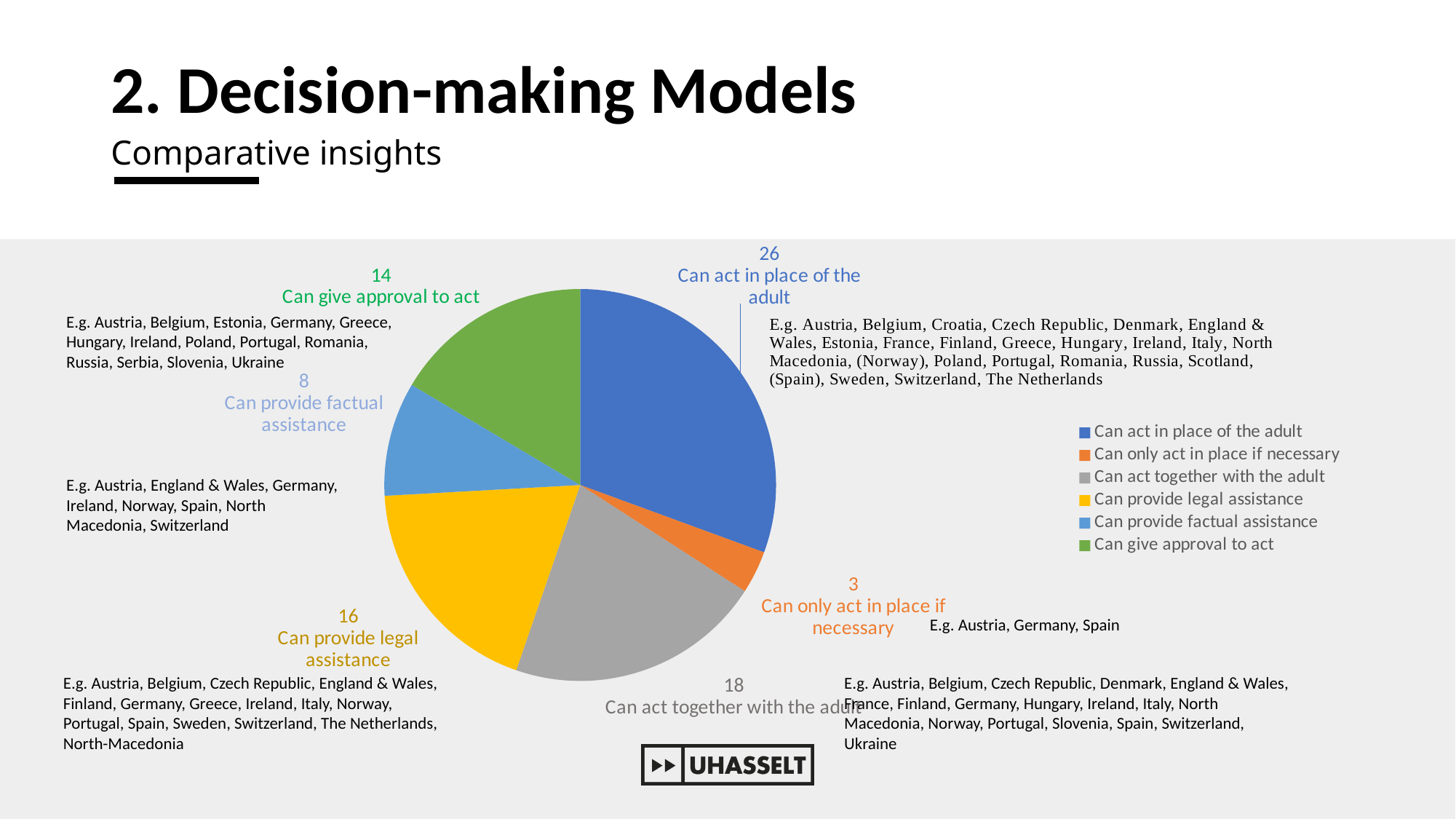
What is the value for 'Can only act in place if necessary'? 3 Which category has the largest slice of the pie? Can act in place of the adult What type of chart is shown on the slide? pie chart How many entries does the legend of the pie chart list? 6 What is the value for 'Can act in place of the adult'? 26 Which category has the smallest slice of the pie? Can only act in place if necessary What is the value for 'Can act together with the adult'? 18 How many slices does the pie chart have? 6 What is the difference between the values for 'Can act in place of the adult' and 'Can provide legal assistance'? 10 What colour is the slice for 'Can provide legal assistance'? yellow What is the value for 'Can provide factual assistance'? 8 Which is larger, the value for 'Can give approval to act' or the value for 'Can provide factual assistance'? Can give approval to act